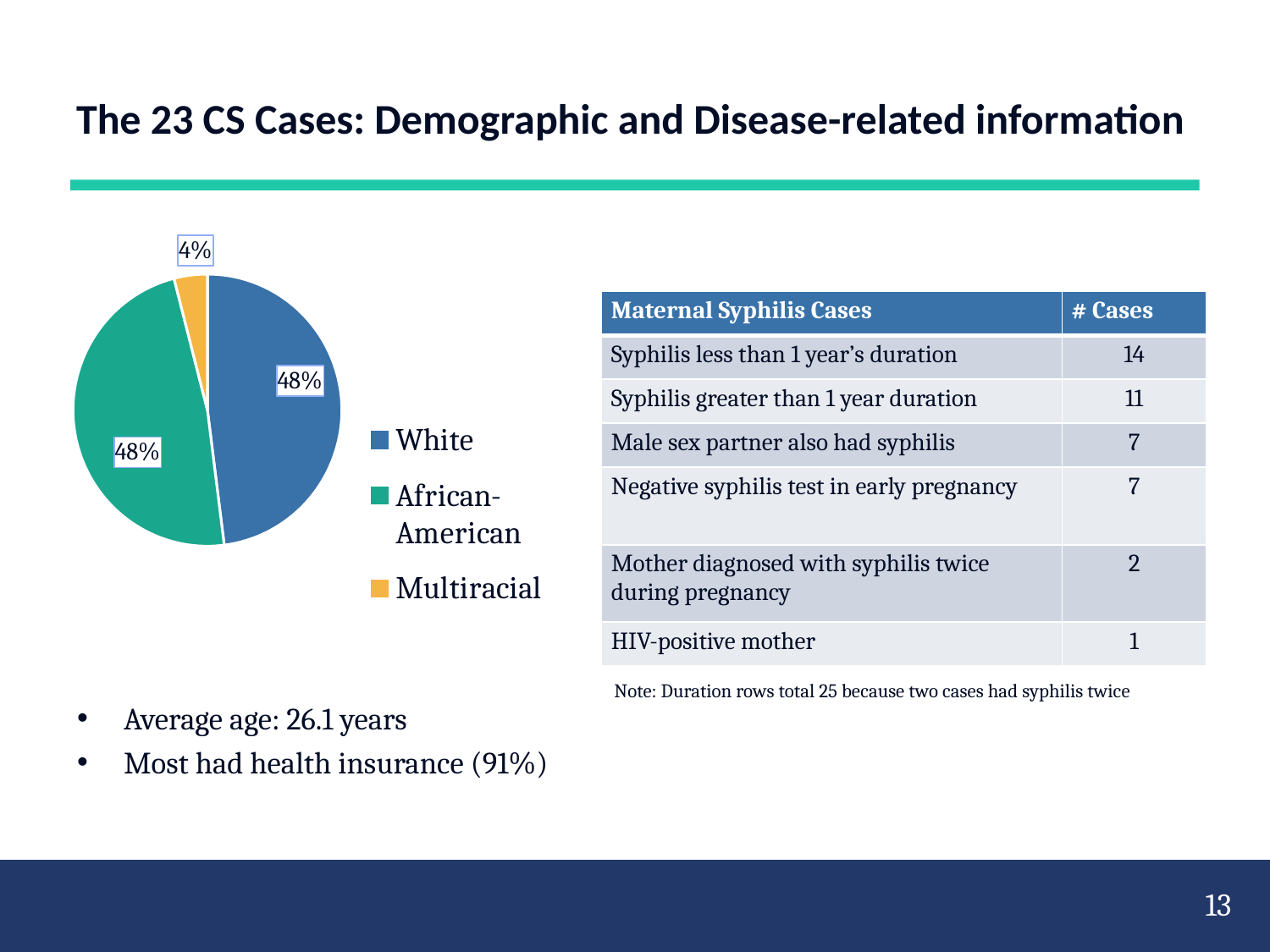
What share of the pie chart does the African-American slice represent? 48% Is the share for the Multiracial slice greater or less than 10%? less What share of the pie chart does the White slice represent? 48% What colour is the Multiracial slice in the pie chart? Yellow What kind of chart is shown on the slide? Pie chart What share of the pie chart does the Multiracial slice represent? 4% Which slice is larger, African-American or Multiracial? African-American How many entries does the pie chart's legend list? 3 What colour is the White slice in the pie chart? Blue Which category has the smallest slice in the pie chart? Multiracial How many slices does the pie chart have? 3 What is the difference in percentage points between the White slice and the Multiracial slice? 44